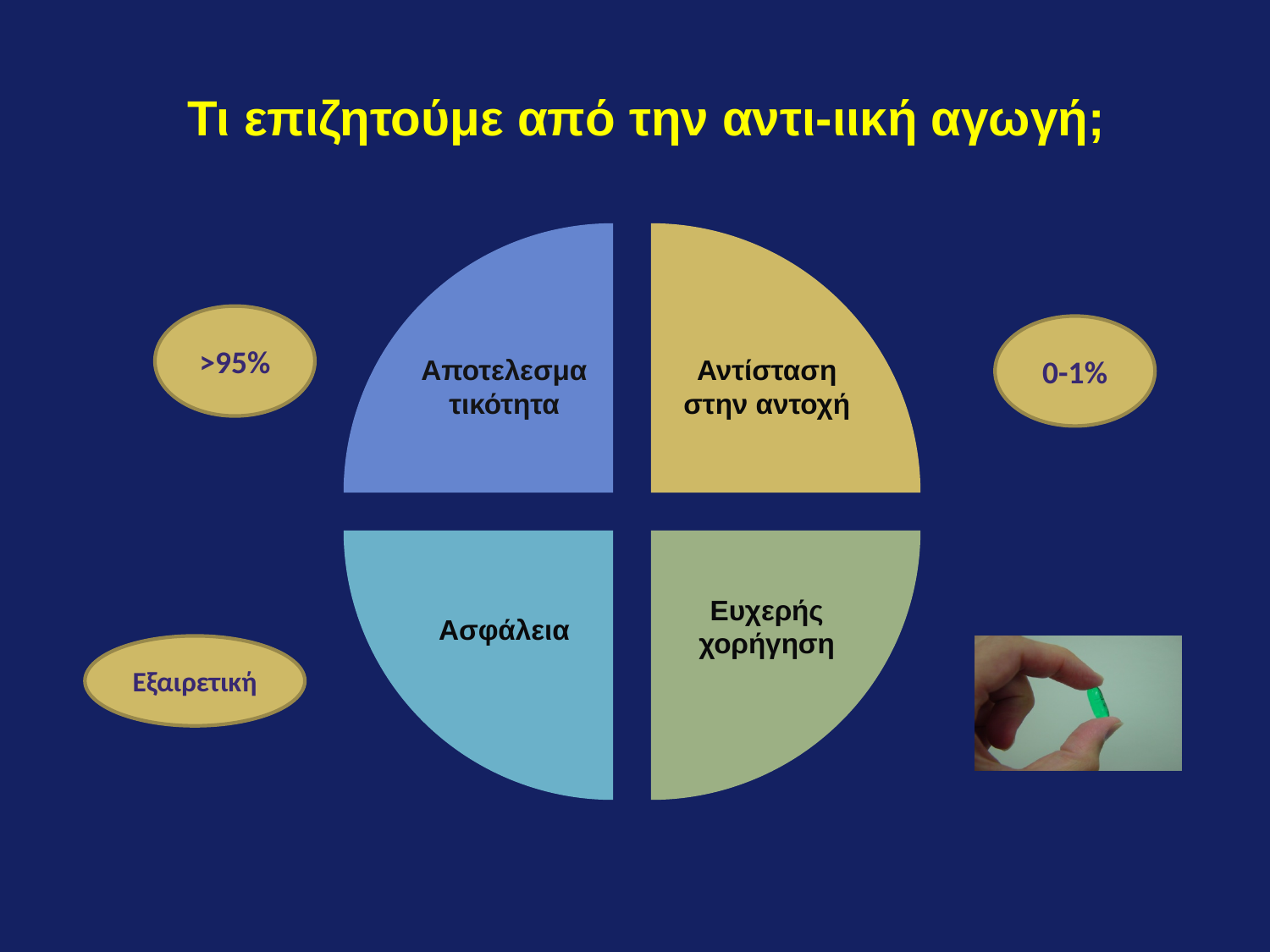
What is the label of the top-left segment of the circular diagram? Αποτελεσματικότητα What value is shown in the oval next to the Αντίσταση στην αντοχή segment? 0-1% What is written in the oval next to the Ασφάλεια segment? Εξαιρετική What is the label of the bottom-right segment of the circular diagram? Ευχερής χορήγηση How many segments does the circular diagram on the slide have? 4 Which segment of the circular diagram is coloured light blue? Ασφάλεια What value is shown in the oval next to the Αποτελεσματικότητα segment? >95% What is the title of the slide containing the circular diagram? Τι επιζητούμε από την αντι-ιική αγωγή;